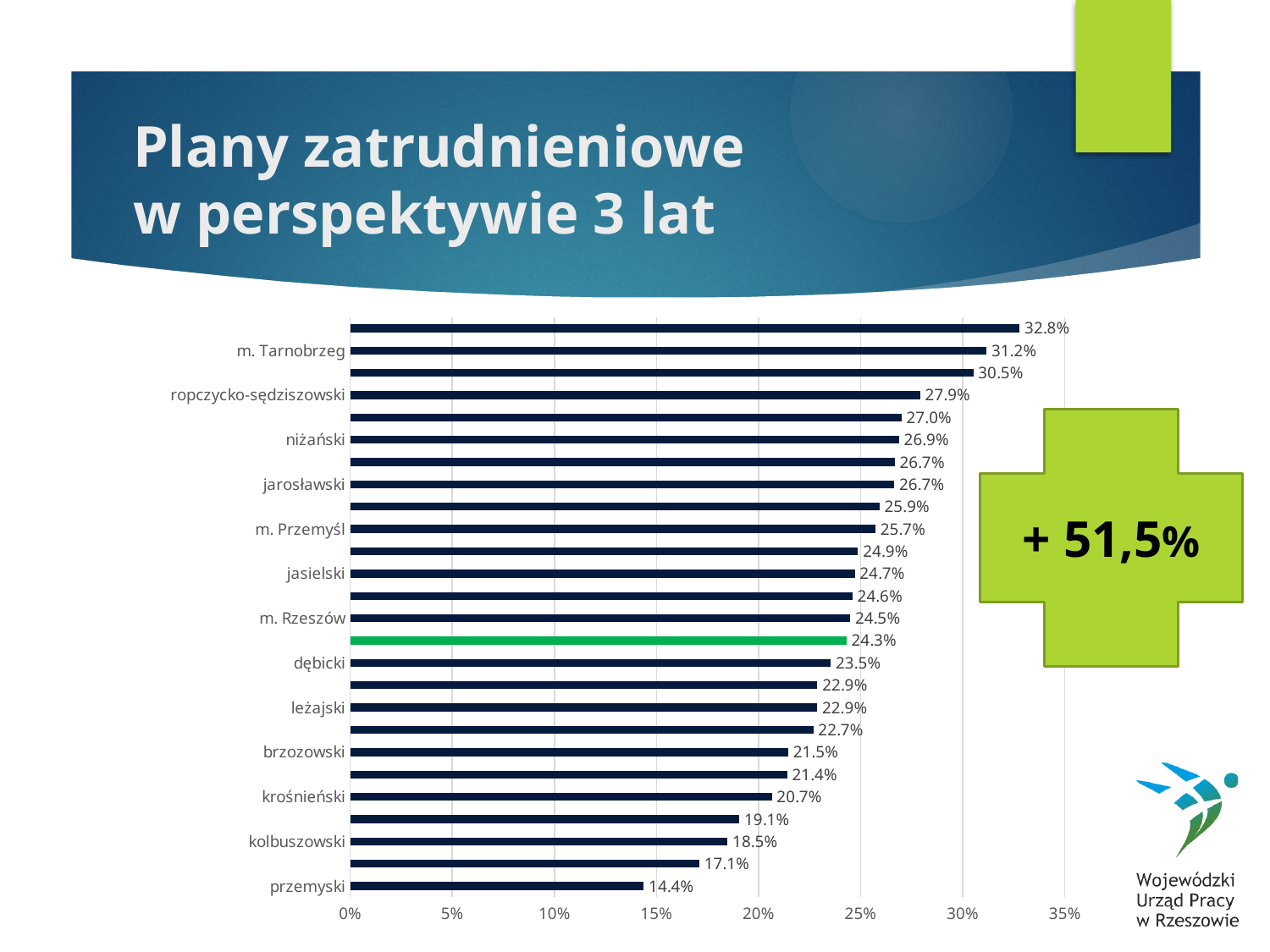
What is the highest value shown on the chart? 32.8% Is the value for brzozowski greater or less than 25%? less Which labelled category has the lowest value? przemyski What is the value for m. Tarnobrzeg? 31.2% What kind of chart is shown on the slide? bar chart How many bars are plotted on the chart? 26 What is the difference between the values for m. Tarnobrzeg and przemyski? 16.8 percentage points What value is shown on the green bar? 24.3% What is the value for m. Rzeszów? 24.5% What is the value for przemyski? 14.4% Which is larger, the value for niżański or the value for jasielski? niżański What is the value for kolbuszowski? 18.5%